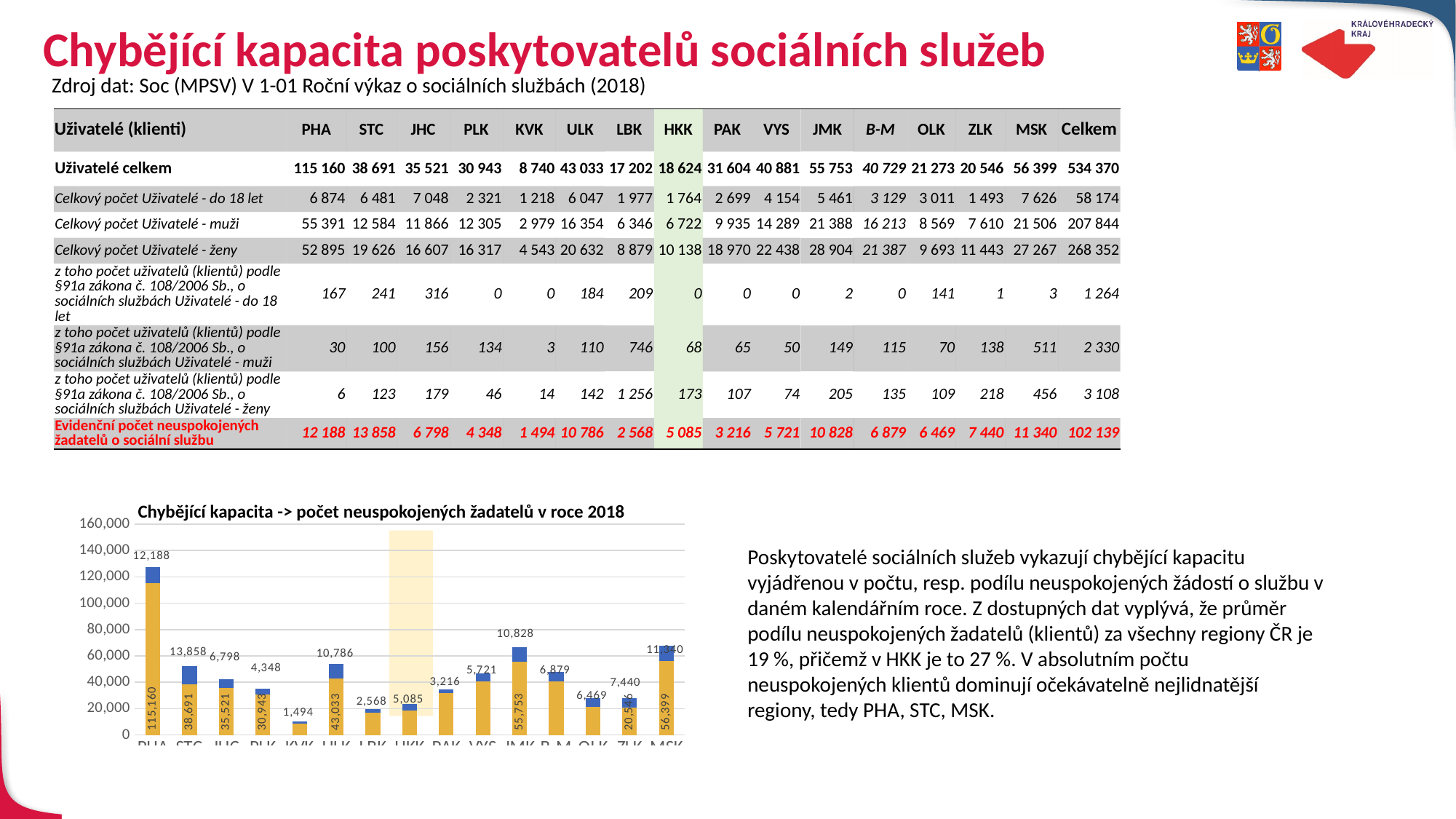
What is the difference between the top-segment values of ULK (10,786) and LBK (2,568)? 8,218 What is the number of unsatisfied applicants (top segment label) for HKK in the chart? 5,085 What is the total of the PHA stacked bar (115,160 + 12,188)? 127,348 What value is printed inside the bottom segment of the JMK bar? 55,753 What value is printed inside the bottom segment of the PHA bar? 115,160 Is the total height of the PHA bar greater or less than 120,000? greater Which region has the tallest bar in the chart? PHA Is the total height of the MSK bar greater or less than 60,000? greater What kind of chart is shown on the slide? bar chart Which region has the shortest bar in the chart? KVK Which has the larger top-segment value, STC (13,858) or MSK (11,340)? STC How many regions (categories) are shown on the x axis of the chart? 15